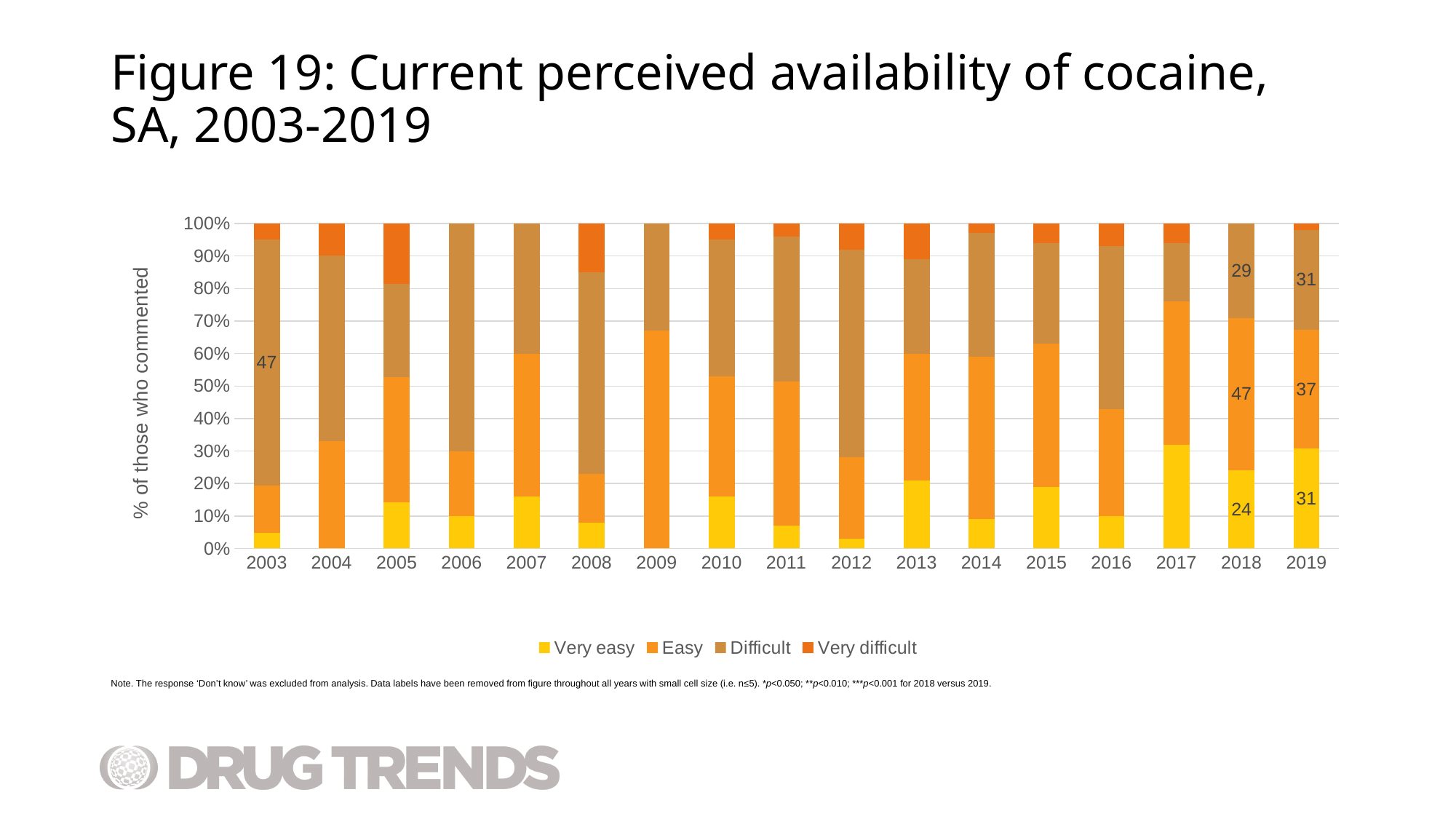
How many series does the legend list? 4 What is the value for Difficult in 2018? 29 What is the value for Very easy in 2019? 31 What is the value for Difficult in 2003? 47 What is the value for Easy in 2018? 47 Which year has the larger Very easy value, 2018 or 2019? 2019 Is the Easy value for 2009 greater or less than 60%? greater How many years are shown on the x axis? 17 What is the value for Easy in 2019? 37 What kind of chart is shown? Stacked bar chart What is the label on the y axis? % of those who commented What is the difference between the Easy values for 2018 and 2019? 10